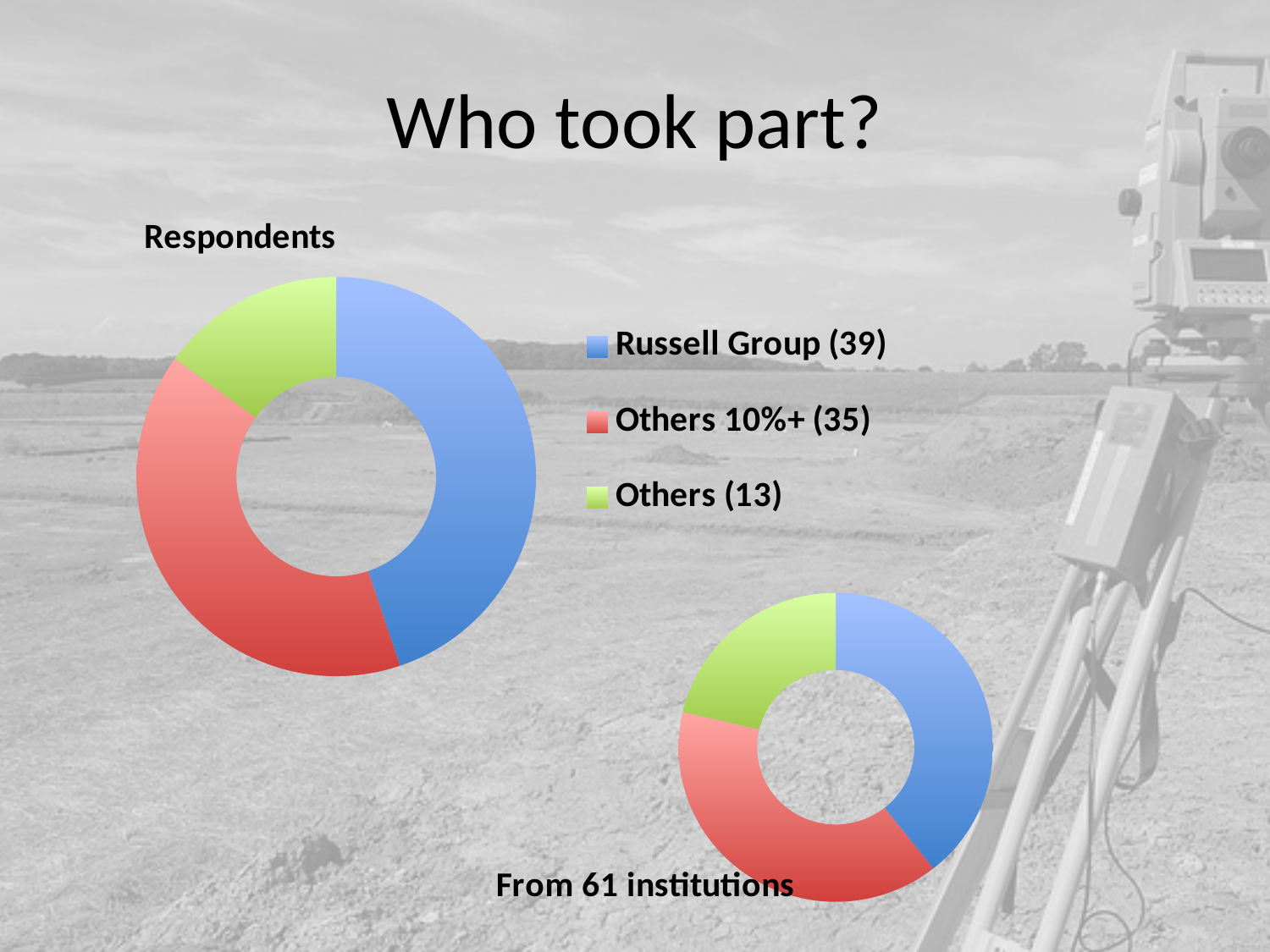
In the Respondents chart, which category has the fewest respondents? Others How many slices does the chart labelled 'From 61 institutions' have? 3 In the Respondents chart, which is larger: Russell Group or Others 10%+? Russell Group In the chart labelled 'From 61 institutions', which colour slice is the smallest? Green In the Respondents chart, what is the difference between the Russell Group count and the Others count? 26 How many categories does the legend of the Respondents chart list? 3 In the Respondents chart, which category has the most respondents? Russell Group In the Respondents chart, how many respondents fall in the Others category? 13 In the Respondents chart, how many respondents fall in the Others 10%+ category? 35 In the Respondents chart, what is the total number of respondents across all three categories? 87 In the Respondents chart, how many respondents were from the Russell Group? 39 What type of chart is the Respondents chart? Doughnut chart